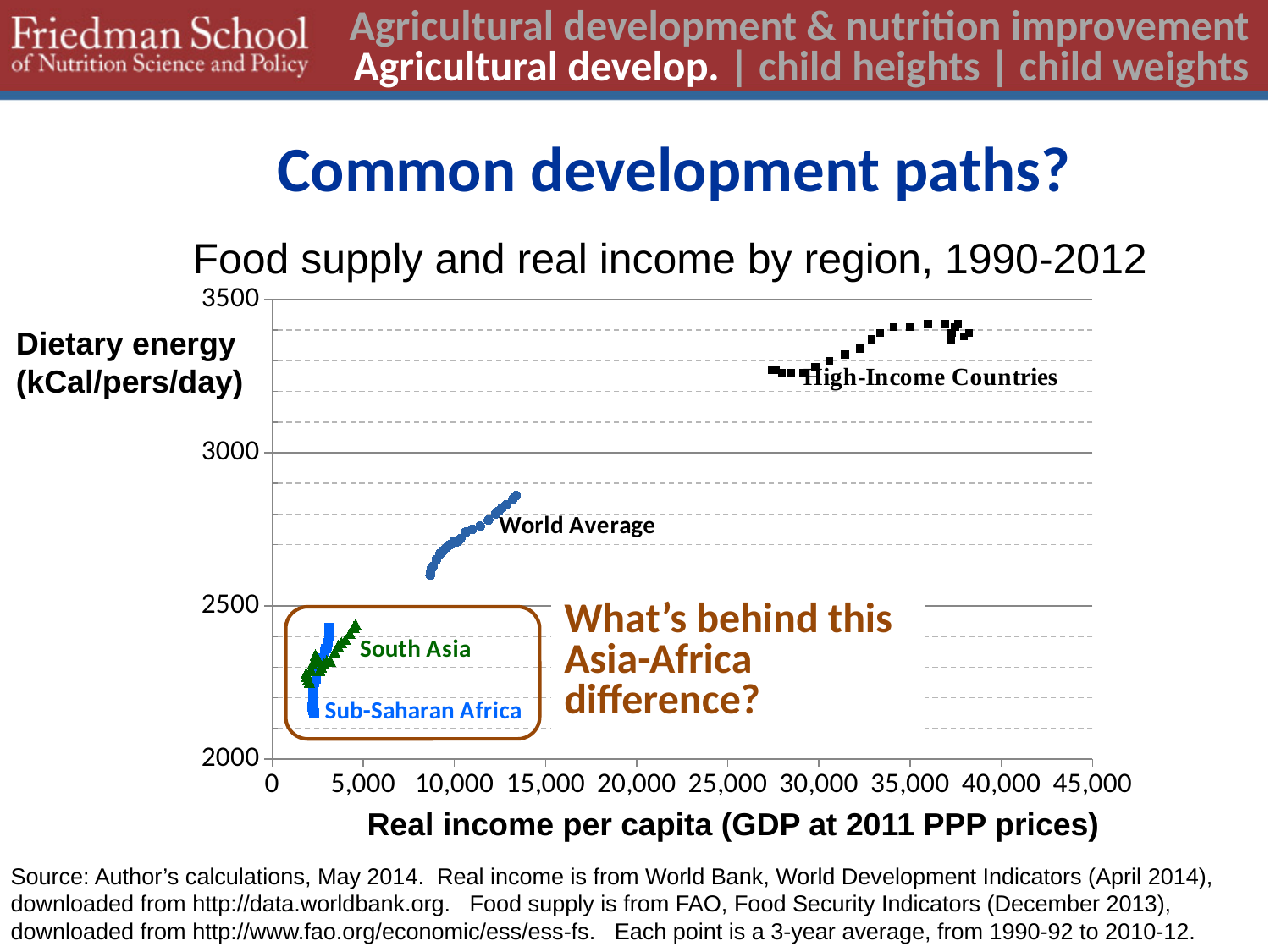
Are the dietary energy values for High-Income Countries greater or less than 3000 kCal/pers/day? greater Are the dietary energy values for the World Average greater or less than 3000 kCal/pers/day? less Which series has higher dietary energy values, World Average or South Asia? World Average What is the title of the chart? Food supply and real income by region, 1990-2012 How many labelled series are plotted on the chart? 4 Which series has the highest dietary energy values? High-Income Countries Which series has the lowest dietary energy values? Sub-Saharan Africa What kind of chart is shown on the slide? scatter chart Are the real income values for the World Average greater or less than 15,000? less Does dietary energy for the World Average rise or fall as real income per capita increases? rise